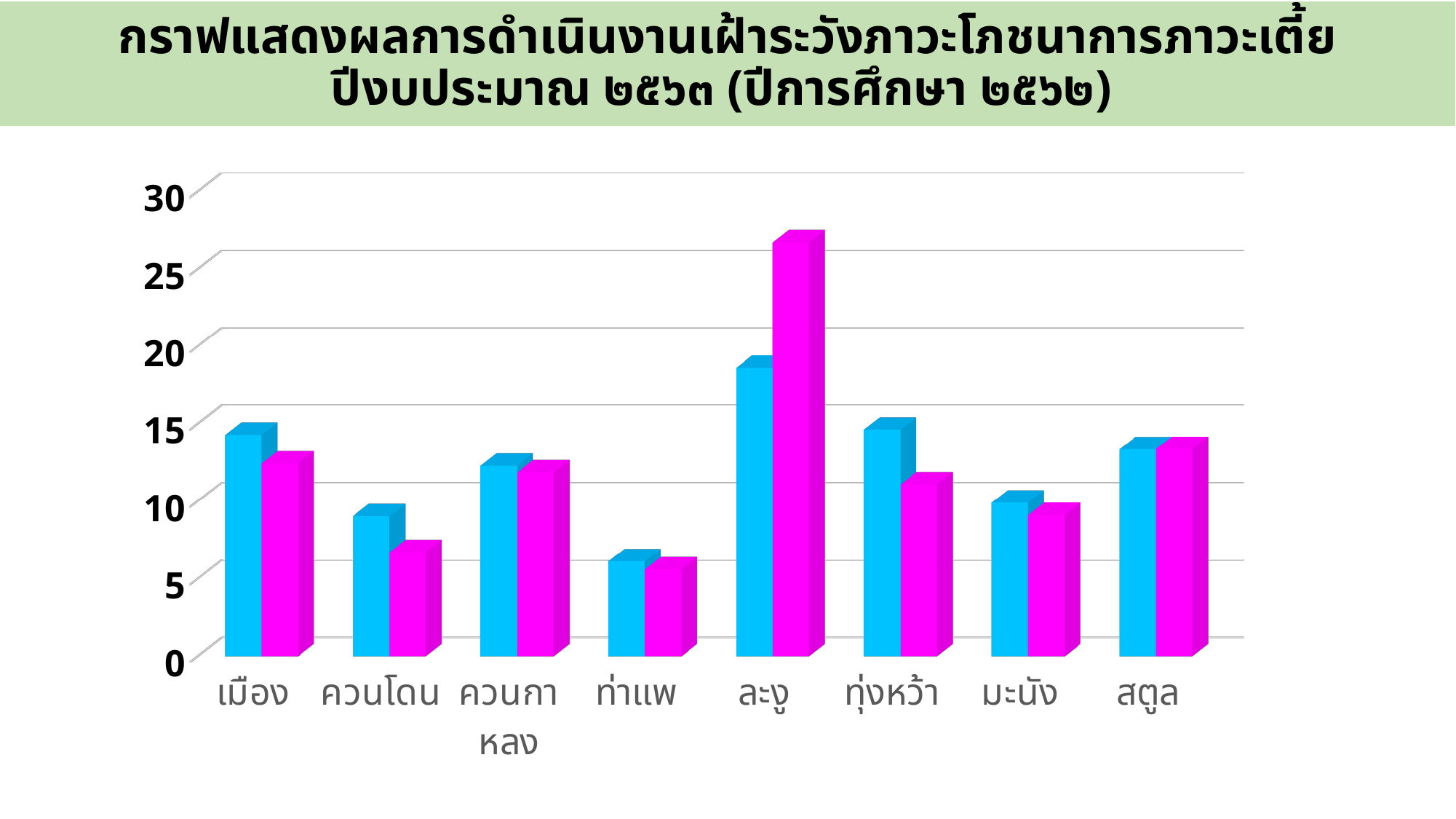
How many categories (districts) are shown on the x axis? 8 For ละงู, which bar is taller, the blue one or the magenta one? magenta Which category has the shortest magenta bar? ท่าแพ Which category has the shortest blue bar? ท่าแพ What kind of chart is shown on the slide? bar chart What is the highest value labelled on the vertical axis? 30 Is the magenta bar for ละงู greater or less than 25? greater Which category has the tallest blue bar? ละงู Is the magenta bar for ควนโดน greater or less than 10? less Is the blue bar for ละงู greater or less than 15? greater Which category has the tallest magenta bar? ละงู For ทุ่งหว้า, which bar is taller, the blue one or the magenta one? blue